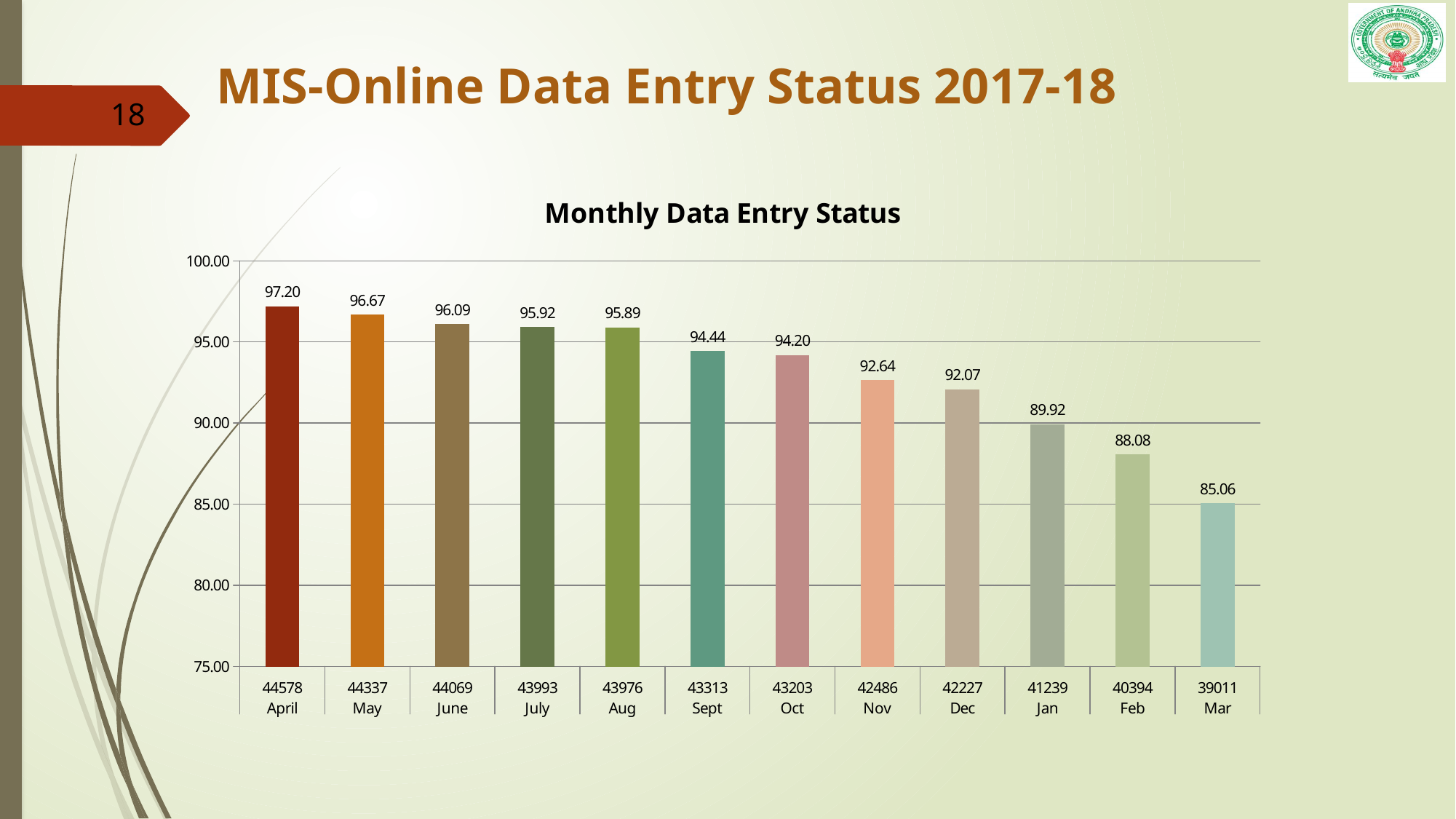
What is the title of the chart on the slide? Monthly Data Entry Status What is the value for April in the Monthly Data Entry Status chart? 97.20 Which is larger in the Monthly Data Entry Status chart, the value for Nov or the value for Jan? Nov Which month has the highest value in the Monthly Data Entry Status chart? April What is the value for Mar in the Monthly Data Entry Status chart? 85.06 What kind of chart is the Monthly Data Entry Status chart? bar chart Do the values in the Monthly Data Entry Status chart rise or fall from April to Mar? fall Is the value for Feb in the Monthly Data Entry Status chart greater or less than 90.00? less What is the value for Sept in the Monthly Data Entry Status chart? 94.44 Which month has the lowest value in the Monthly Data Entry Status chart? Mar How many months are plotted in the Monthly Data Entry Status chart? 12 What is the difference between the values for April and Mar in the Monthly Data Entry Status chart? 12.14